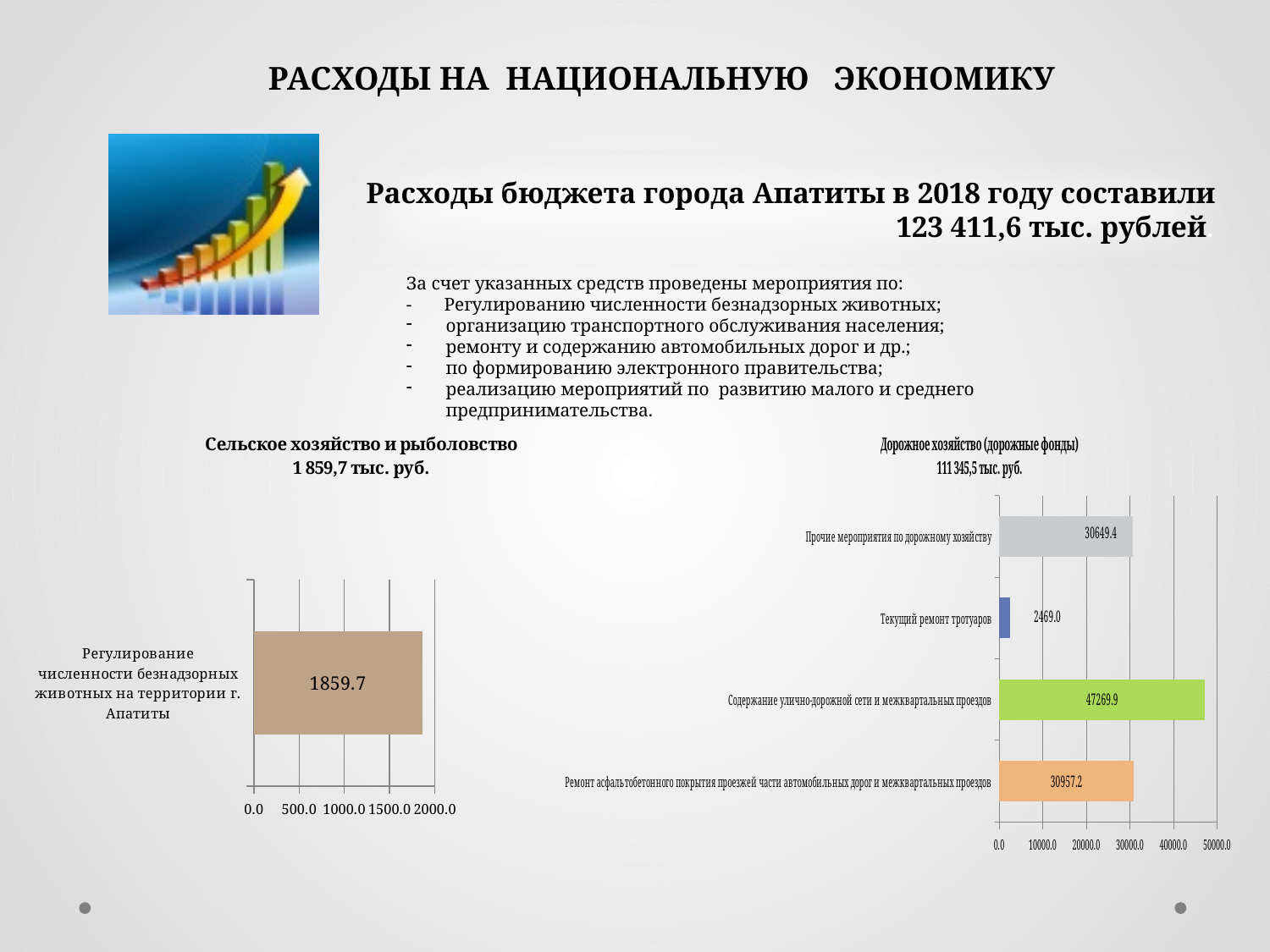
In the chart titled "Дорожное хозяйство (дорожные фонды)", what is the value for "Текущий ремонт тротуаров"? 2469.0 In the chart titled "Дорожное хозяйство (дорожные фонды)", what is the difference between the values for "Ремонт асфальтобетонного покрытия проезжей части автомобильных дорог и межквартальных проездов" and "Прочие мероприятия по дорожному хозяйству"? 307.8 In the chart titled "Сельское хозяйство и рыболовство", what is the value for "Регулирование численности безнадзорных животных на территории г. Апатиты"? 1859.7 In the chart titled "Дорожное хозяйство (дорожные фонды)", which category has the highest value? Содержание улично-дорожной сети и межквартальных проездов In the chart titled "Дорожное хозяйство (дорожные фонды)", what is the value for "Содержание улично-дорожной сети и межквартальных проездов"? 47269.9 In the chart titled "Дорожное хозяйство (дорожные фонды)", which category has the lowest value? Текущий ремонт тротуаров In the chart titled "Дорожное хозяйство (дорожные фонды)", how many categories are plotted? 4 In the chart titled "Сельское хозяйство и рыболовство", how many categories are plotted? 1 In the chart titled "Дорожное хозяйство (дорожные фонды)", what is the value for "Прочие мероприятия по дорожному хозяйству"? 30649.4 In the chart titled "Дорожное хозяйство (дорожные фонды)", is the value for "Текущий ремонт тротуаров" greater or less than 10000.0? less What kind of chart is the chart titled "Сельское хозяйство и рыболовство"? bar chart In the chart titled "Дорожное хозяйство (дорожные фонды)", which is larger: the value for "Содержание улично-дорожной сети и межквартальных проездов" or the value for "Ремонт асфальтобетонного покрытия проезжей части автомобильных дорог и межквартальных проездов"? Содержание улично-дорожной сети и межквартальных проездов